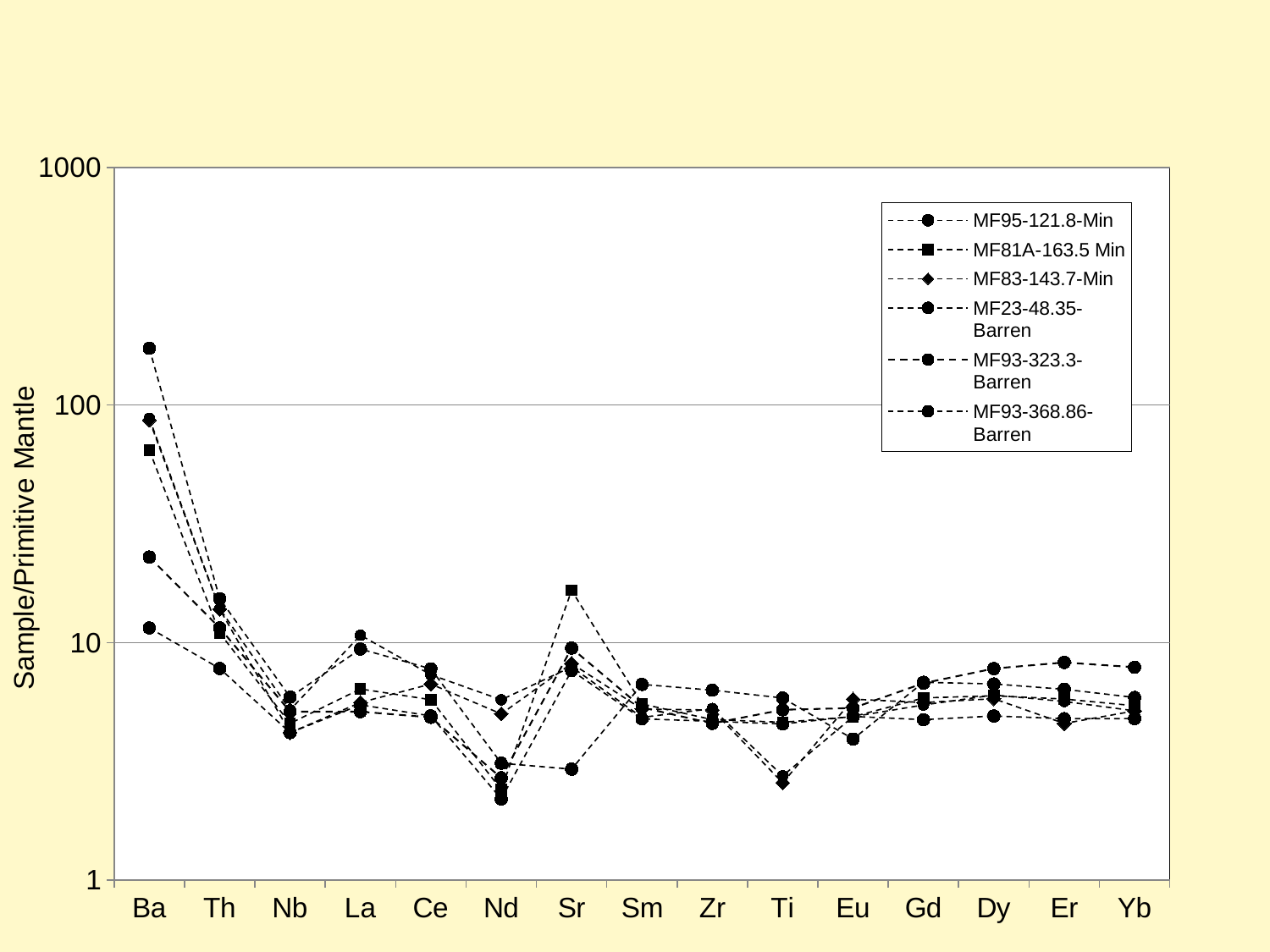
Is the value for MF81A-163.5 Min at Sr greater or less than 10? greater How many categories are shown along the x axis? 15 Which series is listed first in the legend? MF95-121.8-Min Is the value for MF81A-163.5 Min at Nd greater or less than 10? less Is the value for MF83-143.7-Min at Ti greater or less than 10? less What kind of chart is shown on the slide? line chart Do the values for MF81A-163.5 Min rise or fall from Ba to Nb? fall At which category does the highest value on the chart occur? Ba What is the label of the y axis? Sample/Primitive Mantle How many series does the legend list? 6